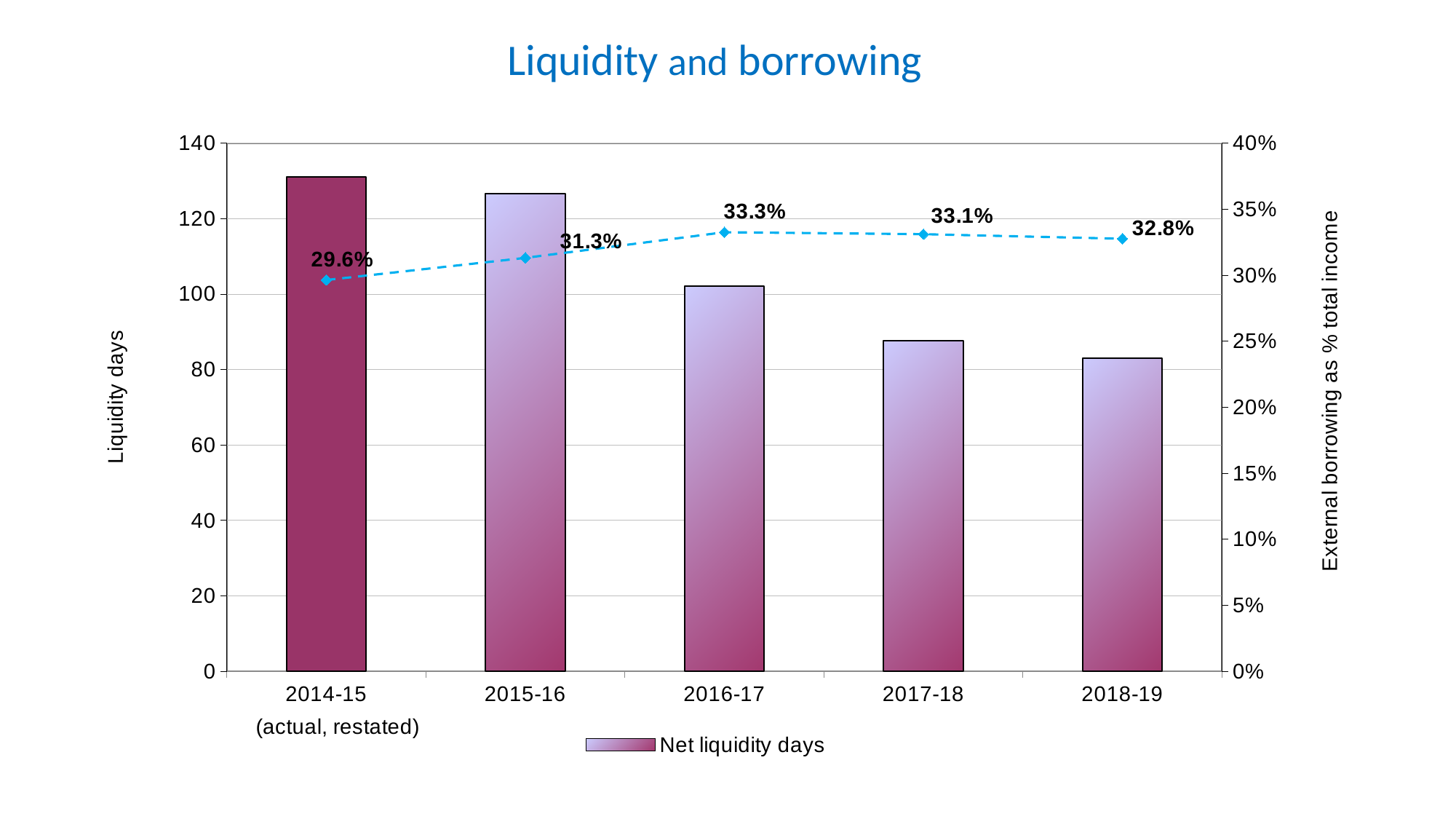
Which year has the highest external borrowing as % of total income? 2016-17 What is the title of the chart? Liquidity and borrowing How many years are shown on the x axis? 5 Is the net liquidity days value for 2017-18 greater or less than 100? less What is the external borrowing as % of total income for 2014-15? 29.6% Which year has the highest net liquidity days? 2014-15 Which year has the lowest external borrowing as % of total income? 2014-15 Do the net liquidity days rise or fall from 2014-15 to 2018-19? fall What is the external borrowing as % of total income for 2016-17? 33.3% What is the difference in external borrowing as % of total income between 2016-17 and 2014-15? 3.7 percentage points Is the net liquidity days value for 2014-15 greater or less than 120? greater What is the external borrowing as % of total income for 2018-19? 32.8%